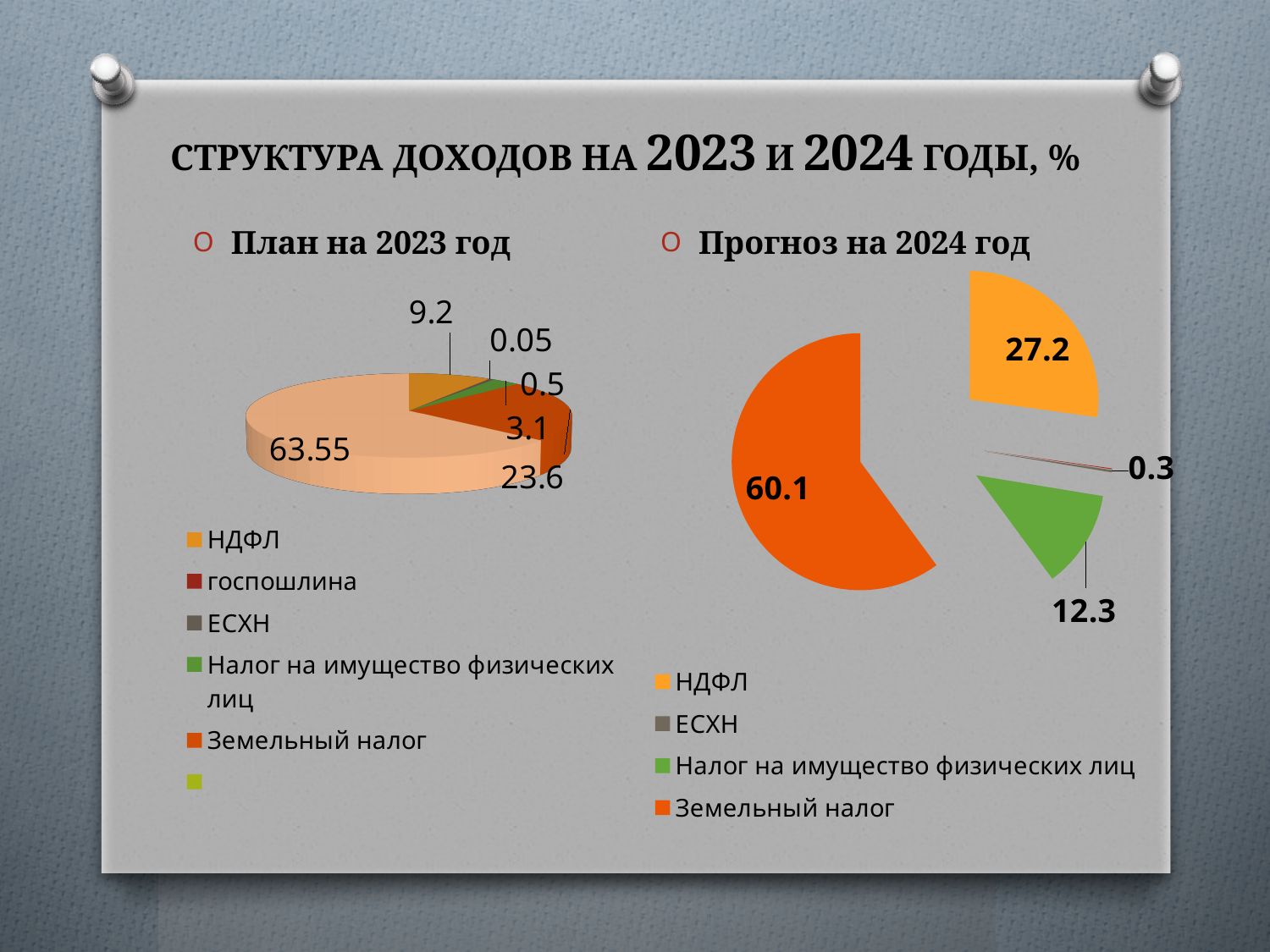
In the chart 'Прогноз на 2024 год', what is the value for Земельный налог? 60.1 In the chart 'Прогноз на 2024 год', what is the value for ЕСХН? 0.3 In the chart 'Прогноз на 2024 год', what is the difference between the values for Земельный налог and НДФЛ? 32.9 In the chart 'Прогноз на 2024 год', which category has the largest share? Земельный налог In the chart 'Прогноз на 2024 год', what is the value for Налог на имущество физических лиц? 12.3 In the chart 'План на 2023 год', what is the value for НДФЛ? 9.2 In the chart 'План на 2023 год', what is the largest value shown on the pie? 63.55 How many entries does the legend of the chart 'Прогноз на 2024 год' list? 4 In the chart 'Прогноз на 2024 год', which is larger: НДФЛ or Налог на имущество физических лиц? НДФЛ What kind of chart is 'План на 2023 год'? pie chart In the chart 'Прогноз на 2024 год', what is the value for НДФЛ? 27.2